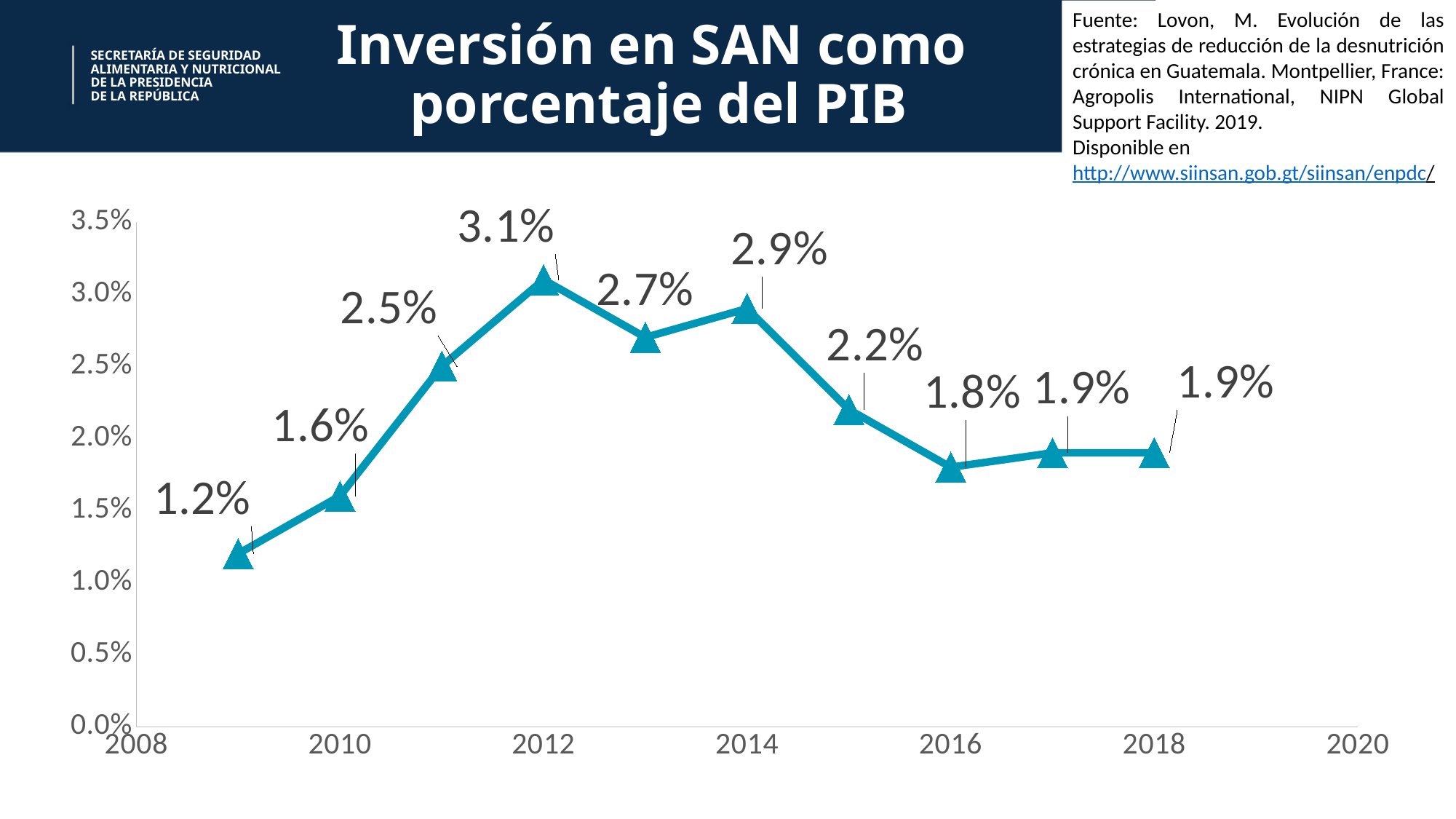
What is the difference between the values for 2012 and 2014? 0.2% What is the value for 2018? 1.9% What type of chart is shown on the slide? line chart What is the value for 2016? 1.8% Which year has the highest value? 2012 How many data points are plotted on the chart? 10 What is the value for 2010? 1.6% Do the values rise or fall from 2014 to 2016? fall What is the lowest value plotted on the chart? 1.2% Which is larger, the value for 2010 or the value for 2016? 2016 What is the value for 2014? 2.9% What is the value for 2012? 3.1%